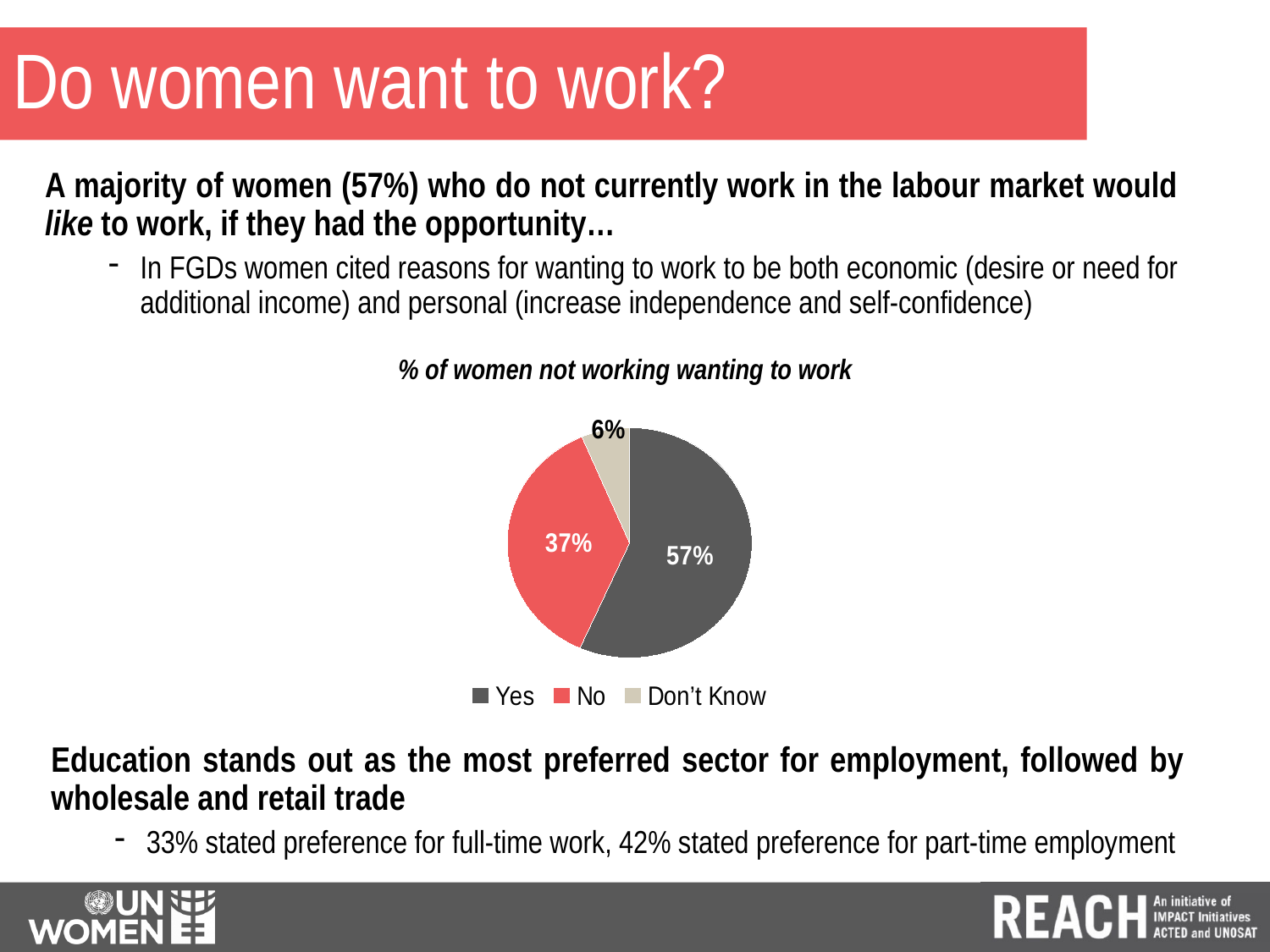
Which colour represents the No category in the pie chart? Red What percentage of women not working answered No to wanting to work? 37% What is the combined share of the Yes and No slices? 94% Which is larger, the share for No or the share for Don't Know? No Which response has the smallest share of the pie? Don't Know What is the title of the chart? % of women not working wanting to work Which response has the largest share of the pie? Yes What kind of chart is shown on the slide? Pie chart What is the difference in percentage points between the Yes and No shares? 20 What percentage of women not working answered Yes to wanting to work? 57% How many categories does the pie chart show? 3 What percentage of women not working answered Don't Know? 6%